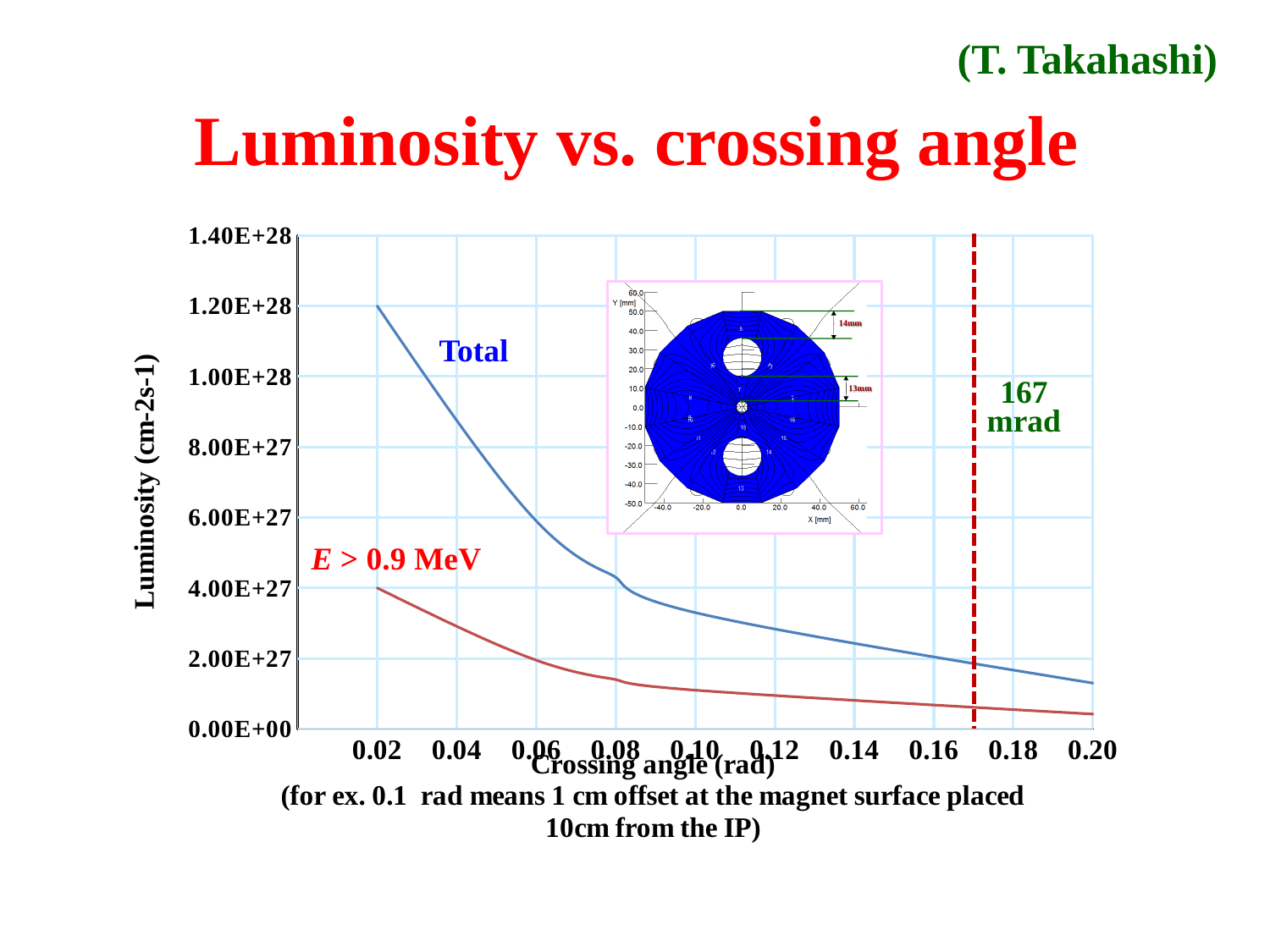
What is the title of the chart? Luminosity vs. crossing angle Is the Total luminosity at a crossing angle of 0.20 rad greater or less than 2.00E+27? less Does the Total luminosity rise or fall as the crossing angle increases? fall What kind of chart is shown on the slide? line chart Is the Total luminosity at a crossing angle of 0.10 rad greater or less than 2.00E+27? greater What is the difference between the Total luminosity and the E > 0.9 MeV luminosity at a crossing angle of 0.02 rad? 8.00E+27 What is the luminosity for E > 0.9 MeV at a crossing angle of 0.02 rad? 4.00E+27 At what crossing angle is the vertical dashed red line drawn, according to its label? 167 mrad Is the E > 0.9 MeV luminosity at a crossing angle of 0.10 rad greater or less than 2.00E+27? less At a crossing angle of 0.06 rad, which series has the higher luminosity, Total or E > 0.9 MeV? Total How many data series are plotted on the chart? 2 What is the Total luminosity at a crossing angle of 0.02 rad? 1.20E+28